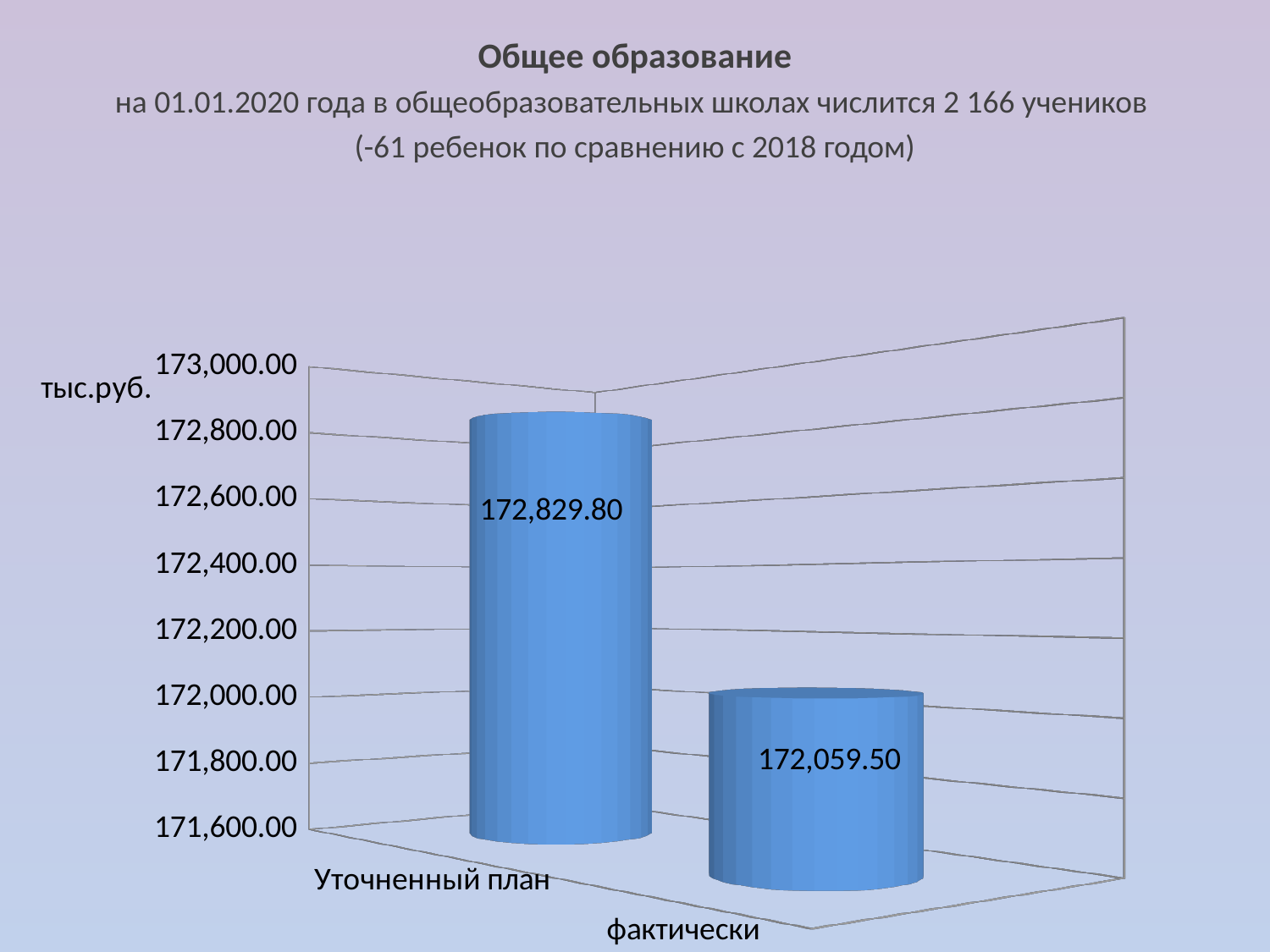
Which category has the highest value? Уточненный план What is the value for Уточненный план? 172,829.80 Which is larger, the value for Уточненный план or the value for фактически? Уточненный план How many categories are shown in the chart? 2 What is the value for фактически? 172,059.50 Is the value for фактически greater or less than 172,200.00? less What is the difference between the values for Уточненный план and фактически? 770.30 Is the value for Уточненный план greater or less than 172,600.00? greater Which category has the lowest value? фактически What kind of chart is shown on the slide? bar chart What unit is shown on the vertical axis of the chart? тыс.руб. What is the title of the slide? Общее образование